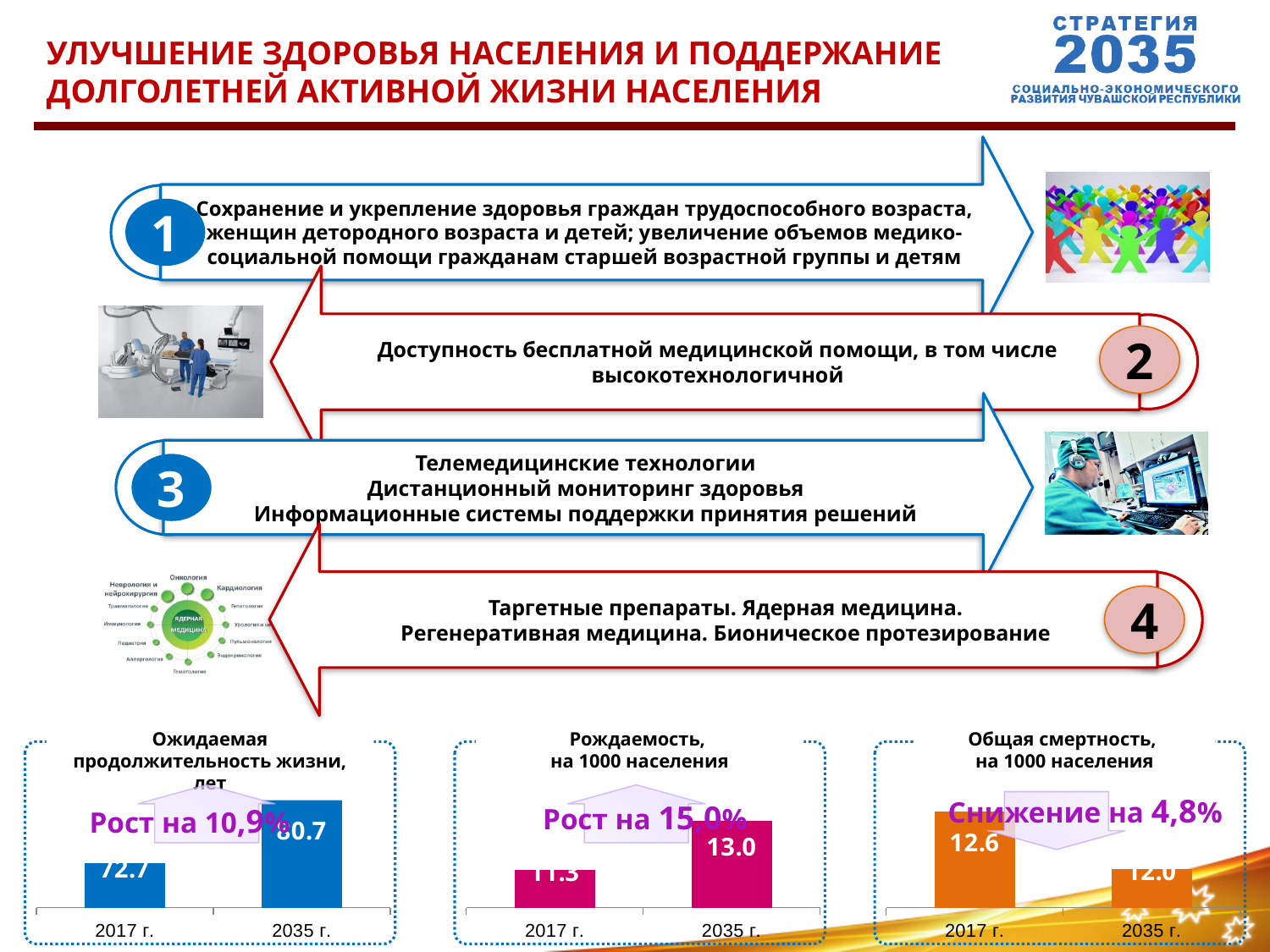
In the chart titled 'Ожидаемая продолжительность жизни, лет', what is the difference between the 2035 г. and 2017 г. values? 8.0 What kind of chart is the one titled 'Общая смертность, на 1000 населения'? bar chart In the chart titled 'Общая смертность, на 1000 населения', what is the value for 2017 г.? 12.6 In the chart titled 'Общая смертность, на 1000 населения', do the values rise or fall from 2017 г. to 2035 г.? fall In the chart titled 'Рождаемость, на 1000 населения', which year has the higher value, 2017 г. or 2035 г.? 2035 г. In the chart titled 'Рождаемость, на 1000 населения', what is the value for 2035 г.? 13.0 In the chart titled 'Ожидаемая продолжительность жизни, лет', what is the value for 2017 г.? 72.7 In the chart titled 'Ожидаемая продолжительность жизни, лет', do the values rise or fall from 2017 г. to 2035 г.? rise In the chart titled 'Рождаемость, на 1000 населения', what is the value for 2017 г.? 11.3 How many categories are shown on the x axis of the chart titled 'Рождаемость, на 1000 населения'? 2 In the chart titled 'Ожидаемая продолжительность жизни, лет', what is the value for 2035 г.? 80.7 What percentage change is annotated on the chart titled 'Общая смертность, на 1000 населения'? Снижение на 4,8%